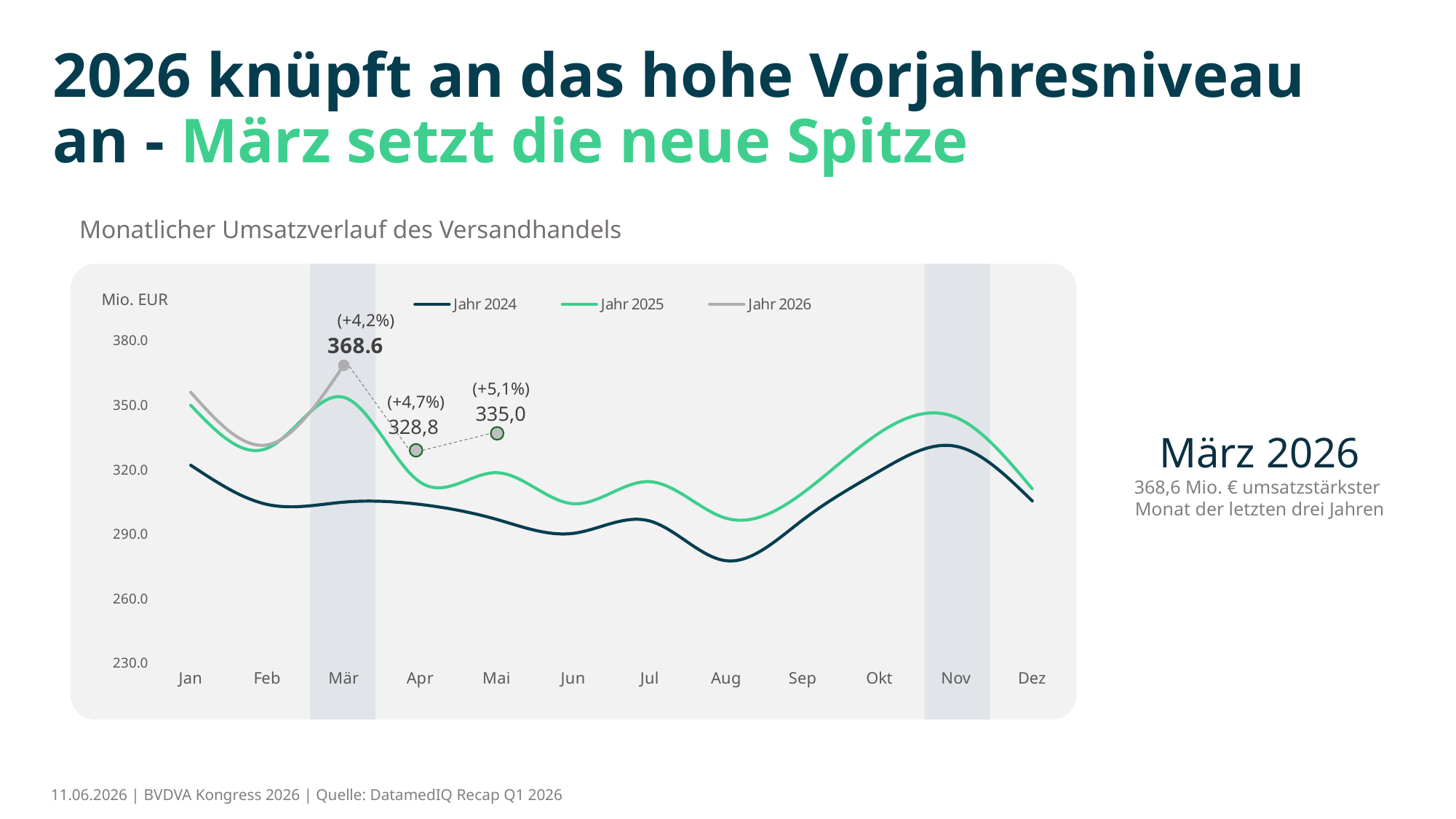
Is the value for Jahr 2024 in Aug greater or less than 290.0? less How many months are shown on the x axis? 12 What is the value for Jahr 2026 in Mär? 368.6 What is the title of the chart? Monatlicher Umsatzverlauf des Versandhandels How many series does the legend list? 3 What is the value for Jahr 2026 in Apr? 328,8 In which month is the Jahr 2024 series at its lowest? Aug What is the value for Jahr 2026 in Mai? 335,0 What kind of chart is shown on the slide? line chart What percentage change is printed above the Mär 2026 data point? +4,2% In Nov, which series has the larger value, Jahr 2024 or Jahr 2025? Jahr 2025 What is the difference between the Jahr 2026 values for Mai and Apr? 6,2